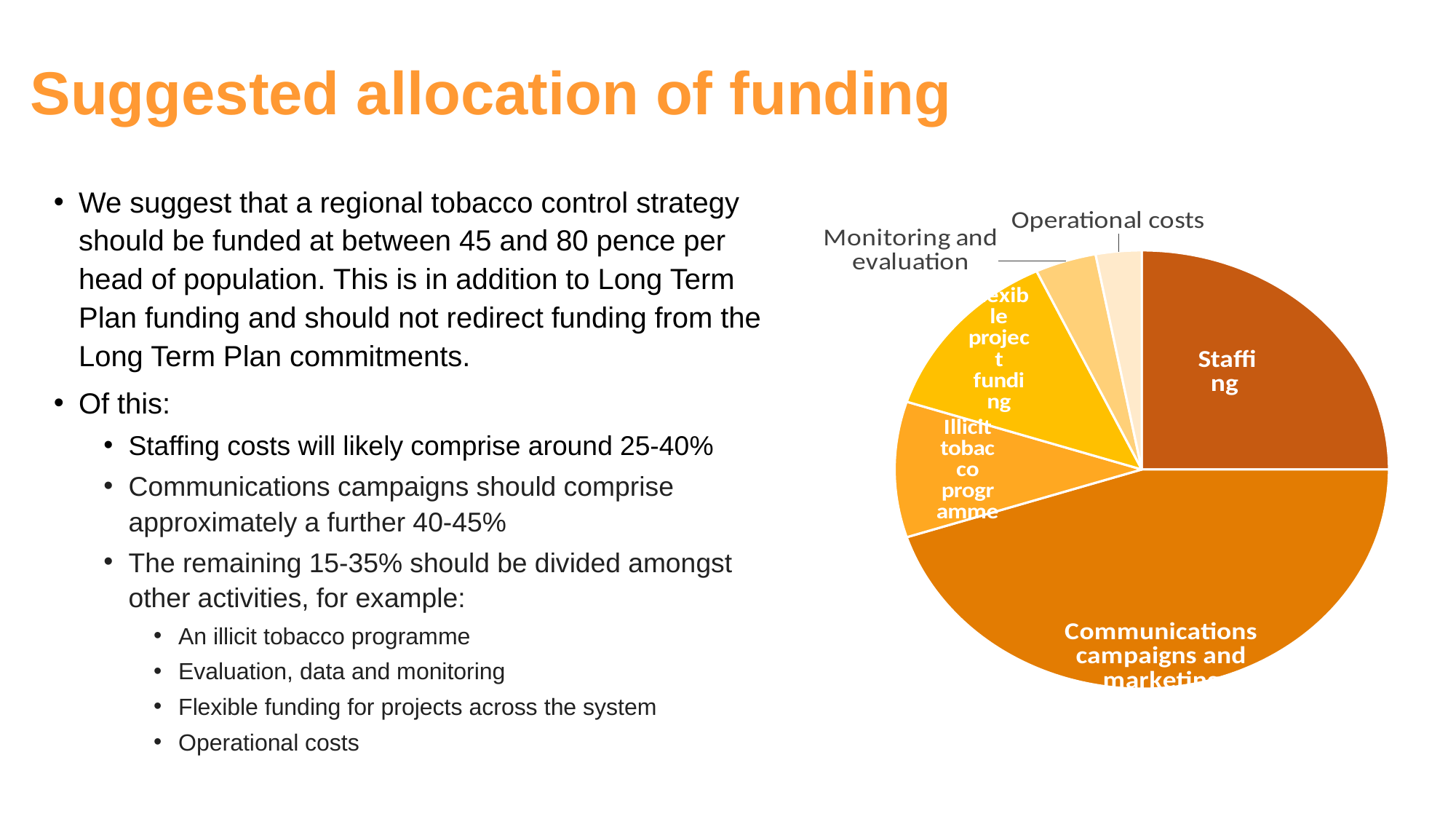
What colour is the Staffing slice of the pie chart? Dark orange-brown How many slices does the pie chart have? 6 Which slice is larger, Staffing or Communications campaigns and marketing? Communications campaigns and marketing Which slice is larger, Staffing or Illicit tobacco programme? Staffing Which two categories in the pie chart are labelled outside the pie with leader lines? Monitoring and evaluation; Operational costs Which slice is larger, Flexible project funding or Operational costs? Flexible project funding Which category has the largest slice of the pie chart? Communications campaigns and marketing What kind of chart is shown on the slide? Pie chart